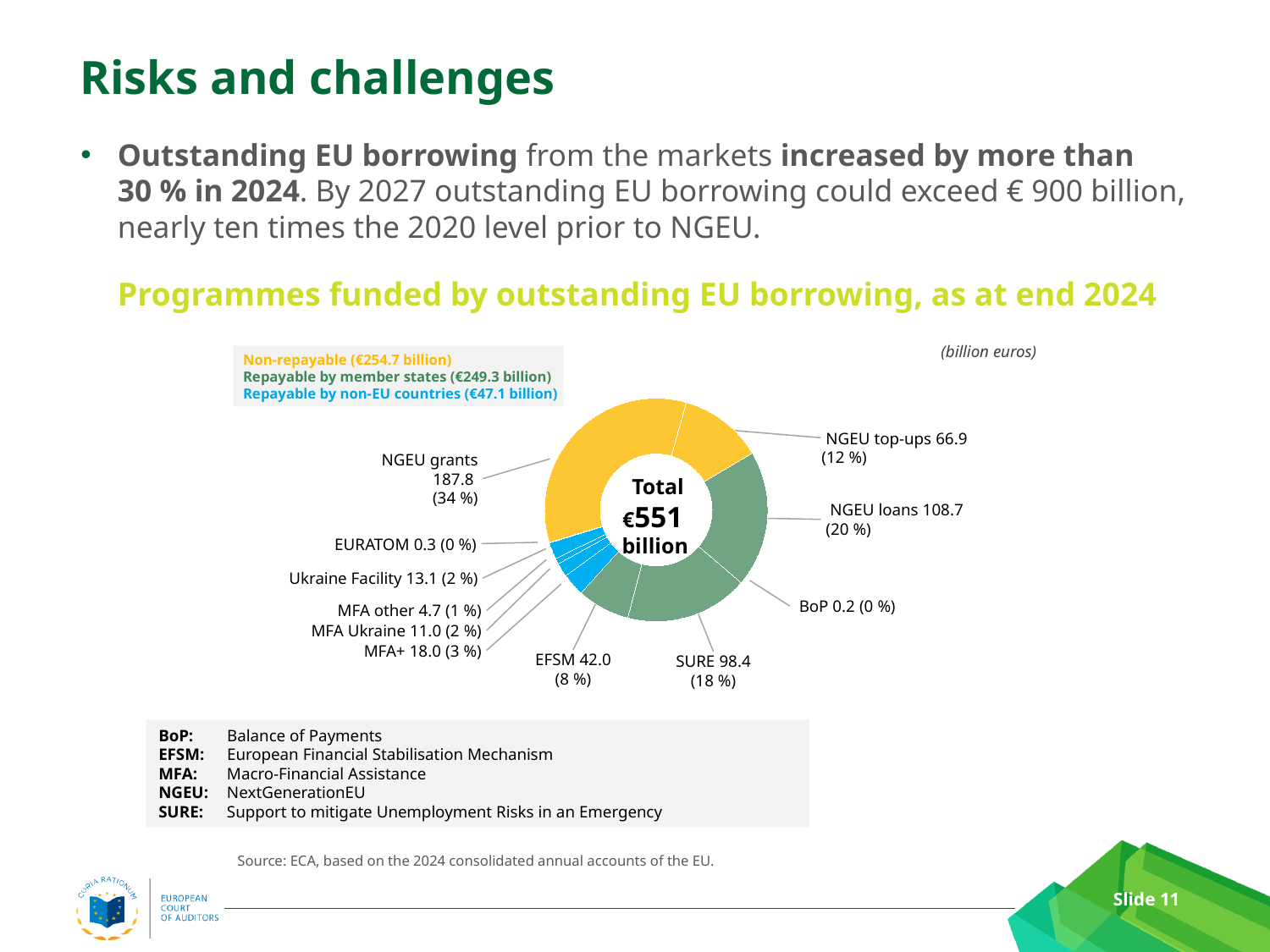
What is the value for NGEU loans? 108.7 What share of the total does NGEU top-ups represent? 12 % What total is shown in the centre of the chart? €551 billion What share of the total does EFSM represent? 8 % What is the value for NGEU grants? 187.8 Which programme has the smallest value in the chart? BoP Which is larger, MFA+ or Ukraine Facility? MFA+ What is the value for SURE? 98.4 What is the difference between NGEU loans and SURE? 10.3 How many programmes are shown in the chart? 11 Which programme has the largest share of outstanding EU borrowing? NGEU grants What kind of chart is shown on the slide? Pie chart (donut)